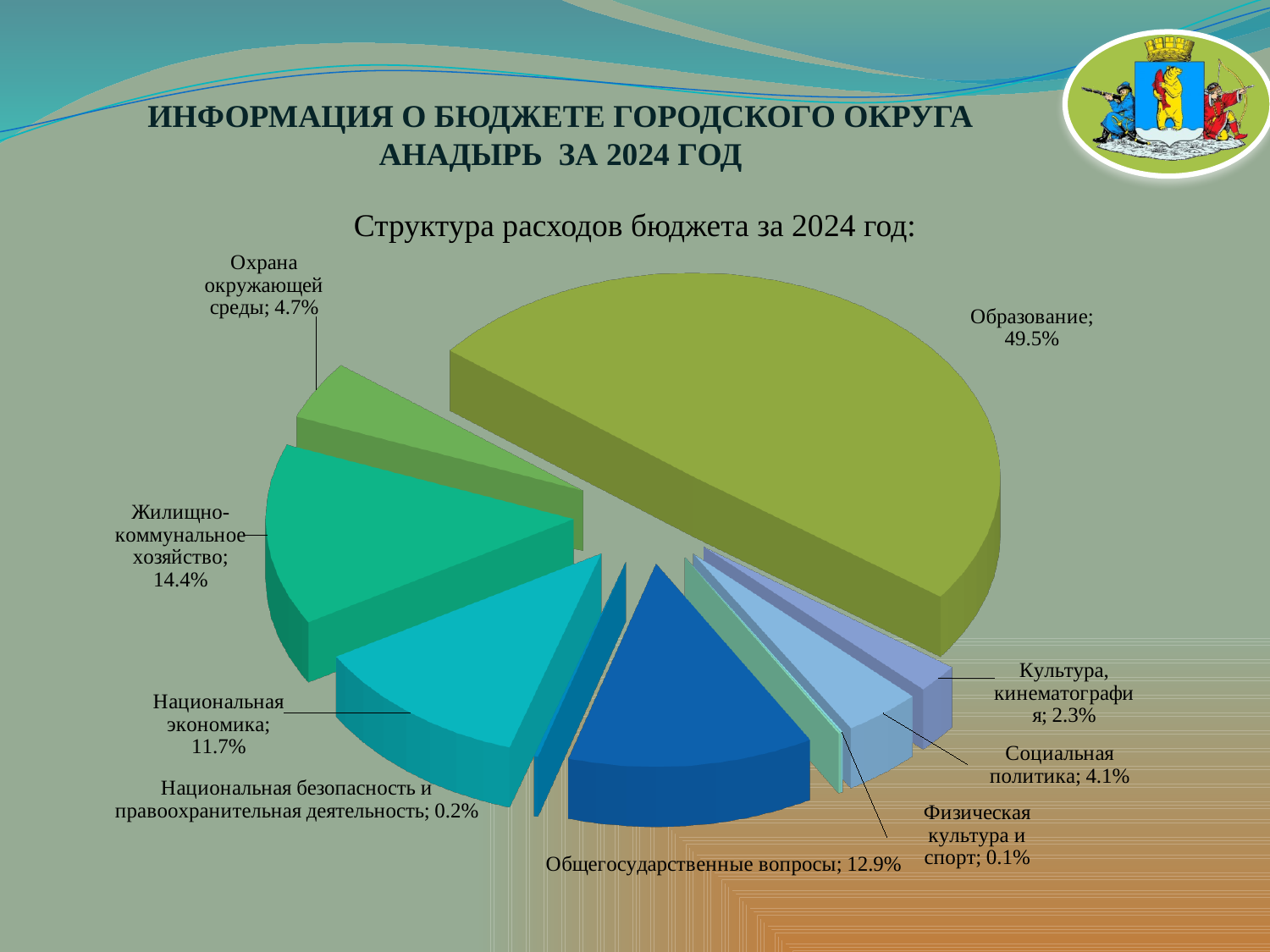
What share of the budget expenditure is Общегосударственные вопросы? 12.9% What share of the budget expenditure is Социальная политика? 4.1% What is the title of the chart? Структура расходов бюджета за 2024 год: What is the difference in percentage points between Жилищно-коммунальное хозяйство and Национальная экономика? 2.7 Which is larger: the share for Охрана окружающей среды or the share for Социальная политика? Охрана окружающей среды What kind of chart is shown on the slide? Pie chart What share of the budget expenditure is Национальная экономика? 11.7% Which category has the largest share of the budget expenditure? Образование What share of the budget expenditure is Жилищно-коммунальное хозяйство? 14.4% What share of the budget expenditure is Образование? 49.5%